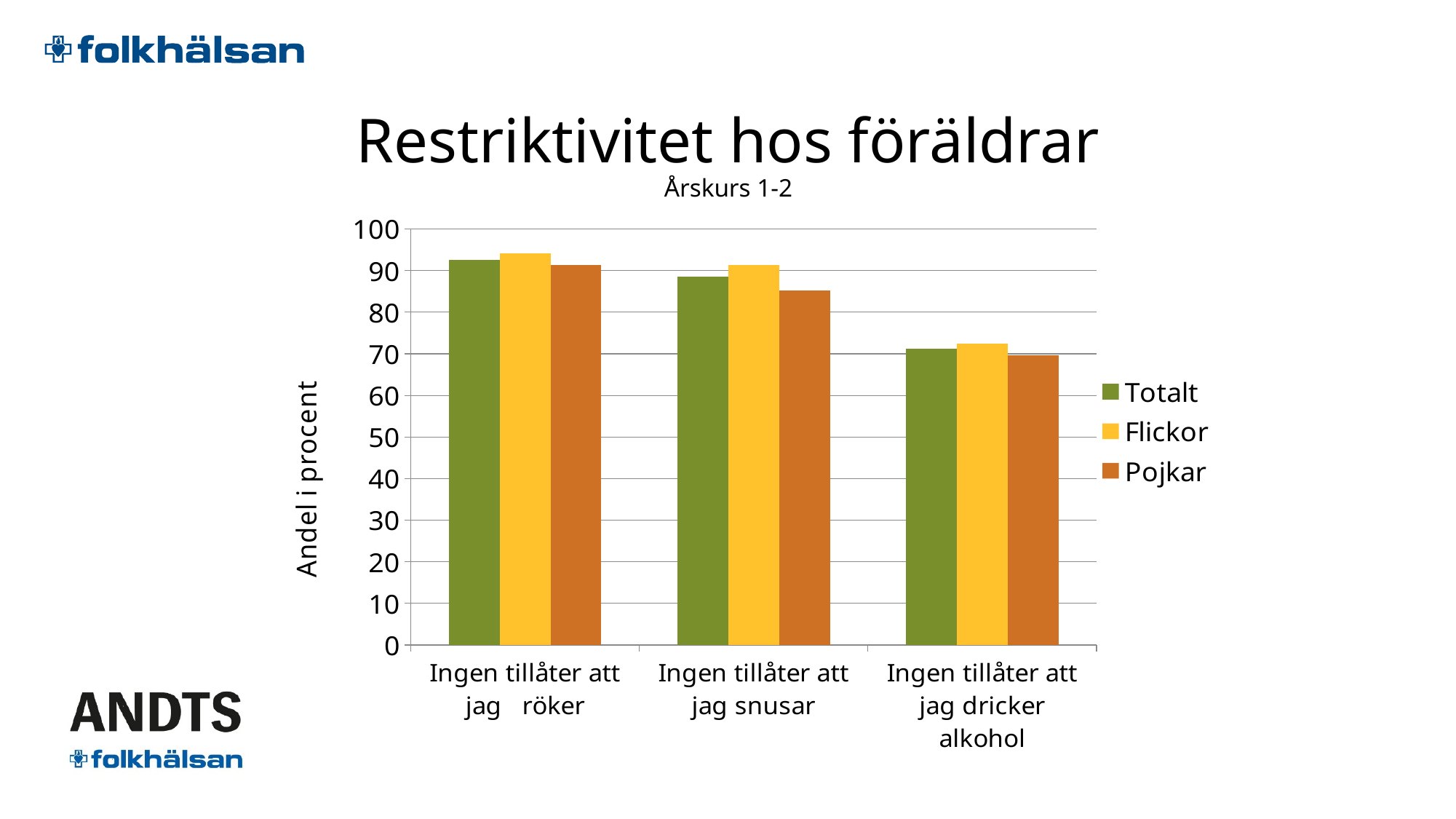
How many series does the legend list? 3 For which category is the Flickor value highest? Ingen tillåter att jag röker Which is larger for Totalt: 'Ingen tillåter att jag röker' or 'Ingen tillåter att jag dricker alkohol'? Ingen tillåter att jag röker How many categories are shown on the x axis? 3 Is the Totalt value for 'Ingen tillåter att jag dricker alkohol' greater or less than 80? less Do the Totalt values rise or fall from left to right across the categories? fall For which category is the Pojkar value lowest? Ingen tillåter att jag dricker alkohol What is the label on the vertical axis? Andel i procent What kind of chart is shown on the slide? bar chart Is the Flickor value for 'Ingen tillåter att jag röker' greater or less than 90? greater Is the Pojkar value for 'Ingen tillåter att jag snusar' greater or less than 90? less For 'Ingen tillåter att jag snusar', which is larger: Flickor or Pojkar? Flickor